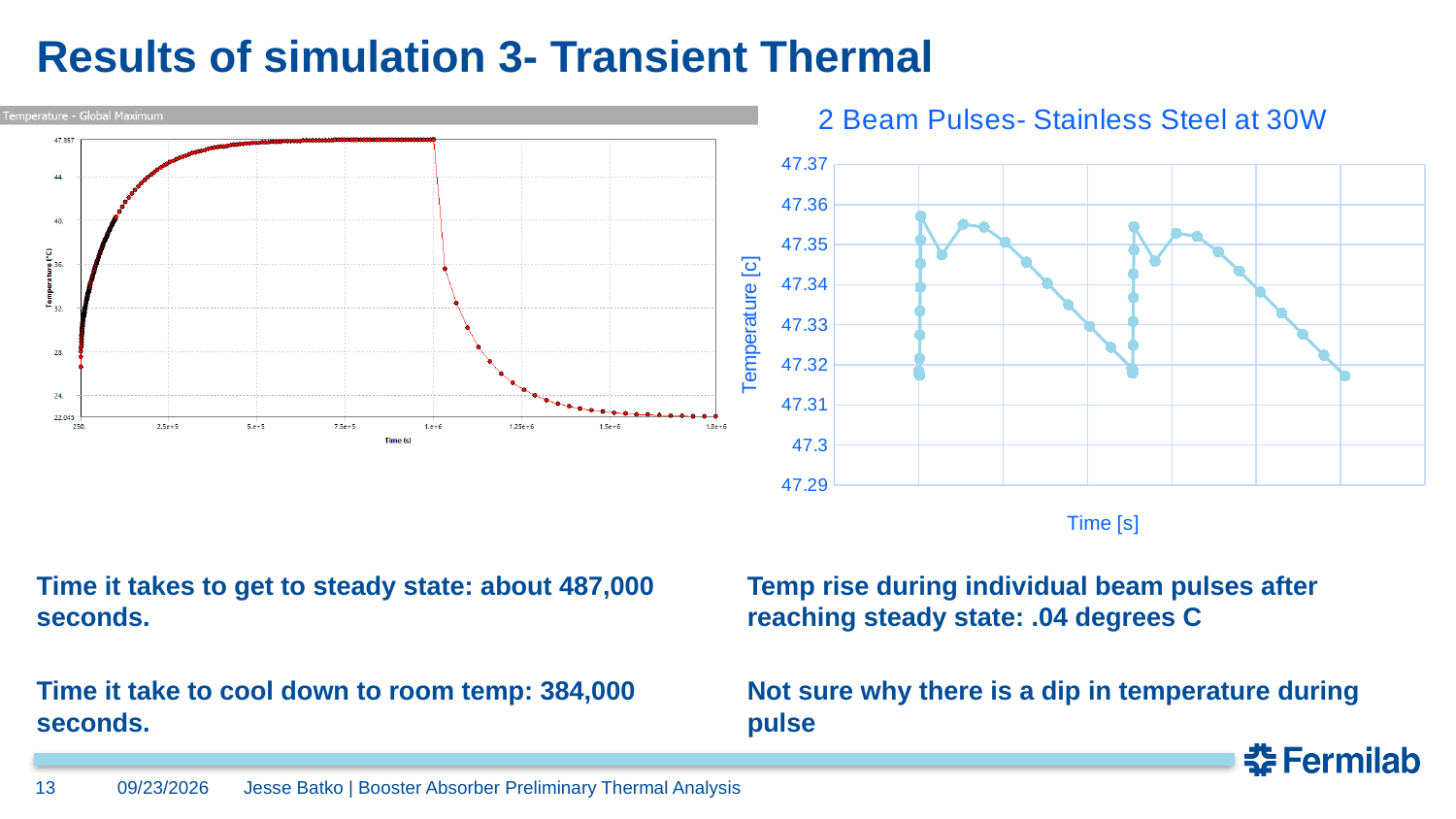
In the 'Temperature - Global Maximum' chart, what is the maximum temperature the curve plateaus at, as marked on the y axis? 47.357 In the 'Temperature - Global Maximum' chart, is the temperature at time 1.25e+6 greater or less than 32? less In the '2 Beam Pulses- Stainless Steel at 30W' chart, is the last plotted point greater or less than 47.33? less What is the title of the chart on the left side of the slide? Temperature - Global Maximum In the 'Temperature - Global Maximum' chart, does the temperature rise or fall between time 250 and 5.e+5? rise In the '2 Beam Pulses- Stainless Steel at 30W' chart, is the lowest temperature reached greater or less than 47.33? less What is the y-axis label of the '2 Beam Pulses- Stainless Steel at 30W' chart? Temperature [c] What kind of chart is the 'Temperature - Global Maximum' chart on the left? line chart In the 'Temperature - Global Maximum' chart, does the temperature rise or fall after time 1.e+6? fall What kind of chart is the '2 Beam Pulses- Stainless Steel at 30W' chart on the right? line chart In the 'Temperature - Global Maximum' chart, what is the lowest value marked on the y axis? 22.045